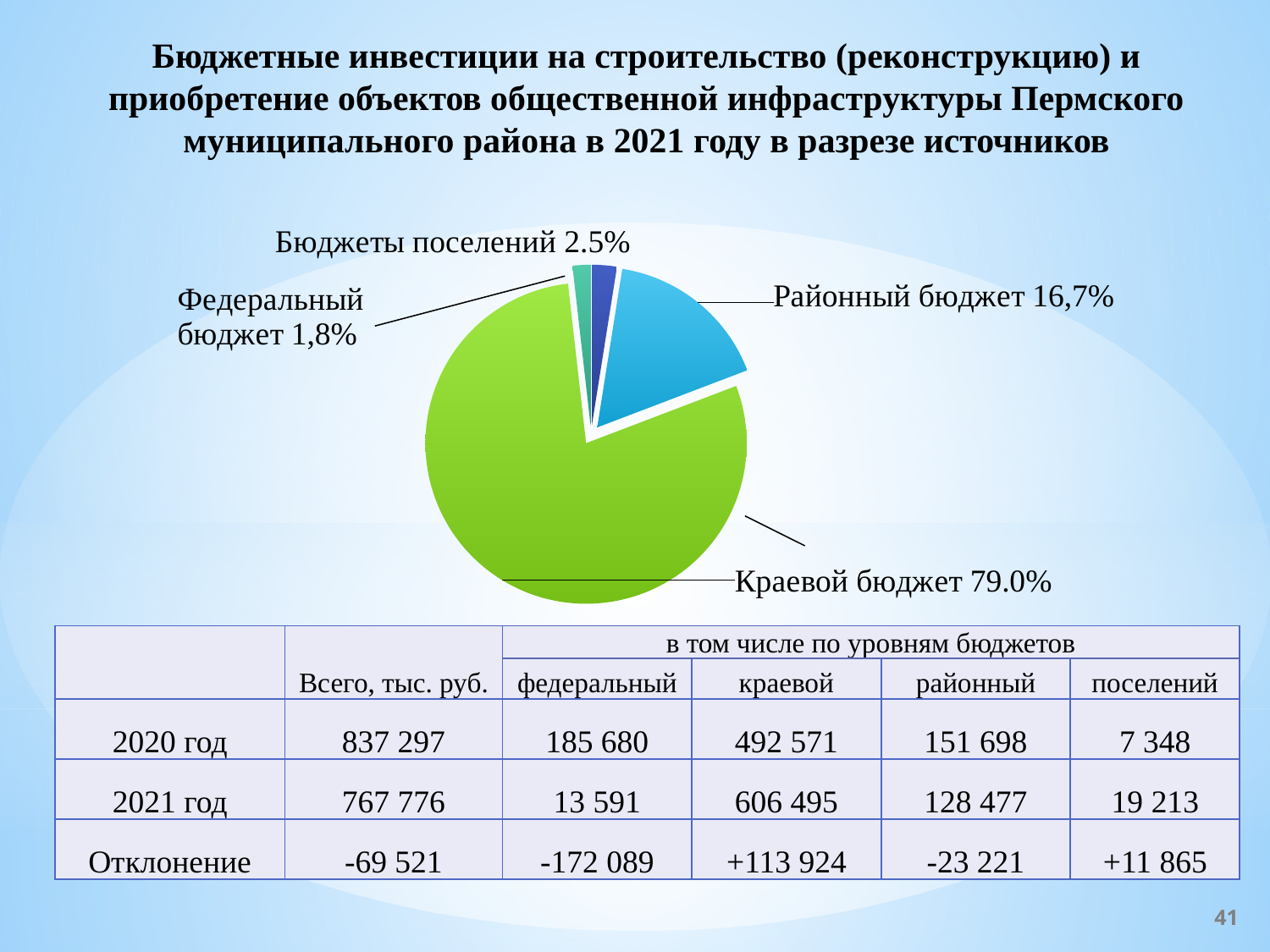
What kind of chart is shown on the slide? Pie chart What is the value shown for Районный бюджет? 16,7% Which year does the slide title say the budget investments refer to? 2021 By how many percentage points does the share of Краевой бюджет exceed the share of Районный бюджет? 62.3% How many slices does the pie chart have? 4 What share of the pie does Краевой бюджет account for? 79.0% Which is larger, the share of Районный бюджет or the share of Бюджеты поселений? Районный бюджет What is the value shown for Федеральный бюджет? 1,8% What colour is the slice for Краевой бюджет? Green Which source has the largest slice of the pie? Краевой бюджет Which source has the smallest slice of the pie? Федеральный бюджет What is the value shown for Бюджеты поселений? 2.5%